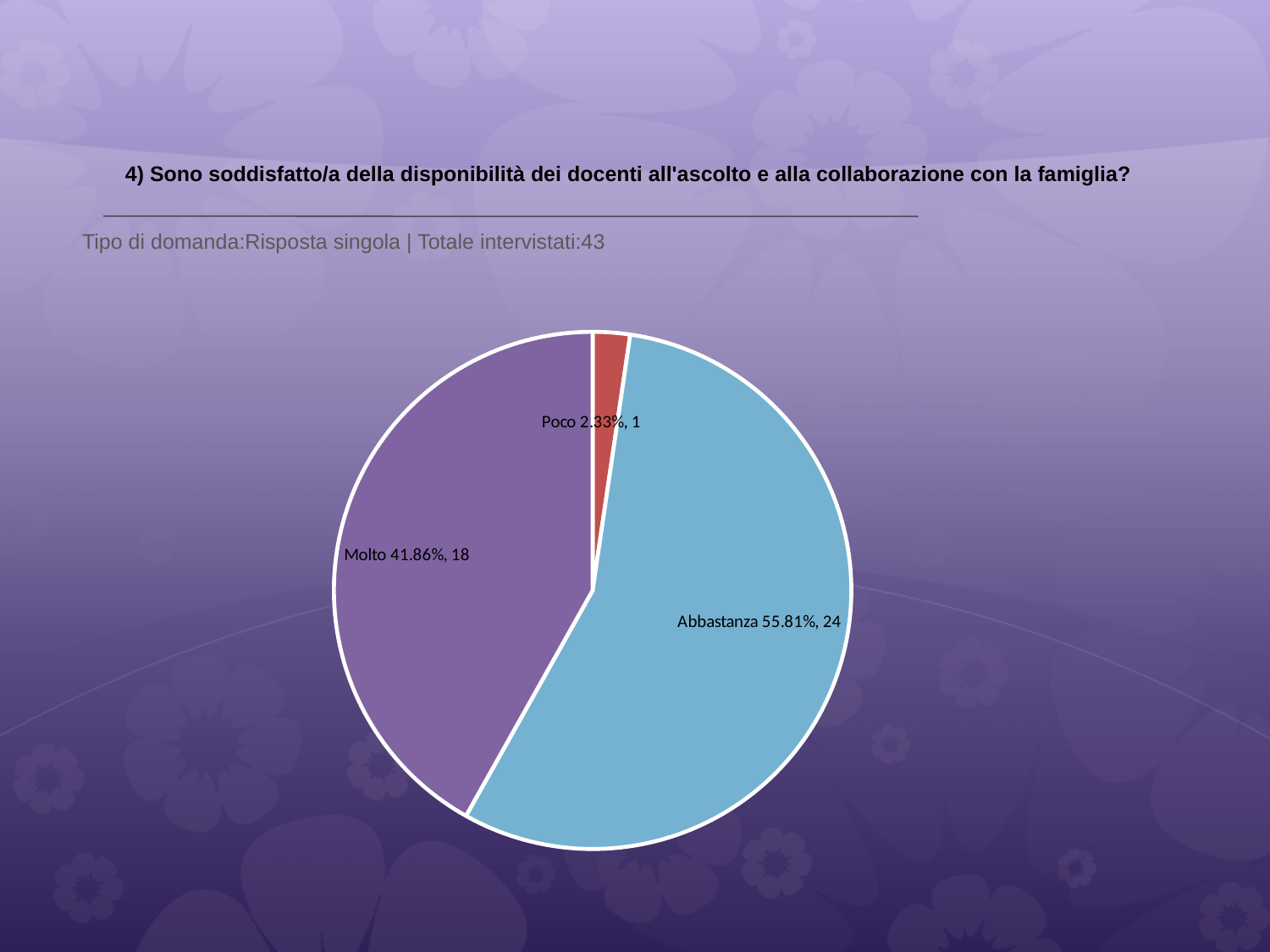
How many respondents answered Poco? 1 Which is larger, the Molto slice or the Poco slice? Molto What is the difference in respondent count between Abbastanza and Molto? 6 How many respondents answered Molto? 18 How many respondents answered Abbastanza? 24 What percentage share does the Abbastanza slice have? 55.81% What percentage share does the Molto slice have? 41.86% Which category has the smallest slice? Poco How many slices does the pie chart have? 3 What kind of chart is shown on the slide? pie chart Which category has the largest slice? Abbastanza What percentage share does the Poco slice have? 2.33%